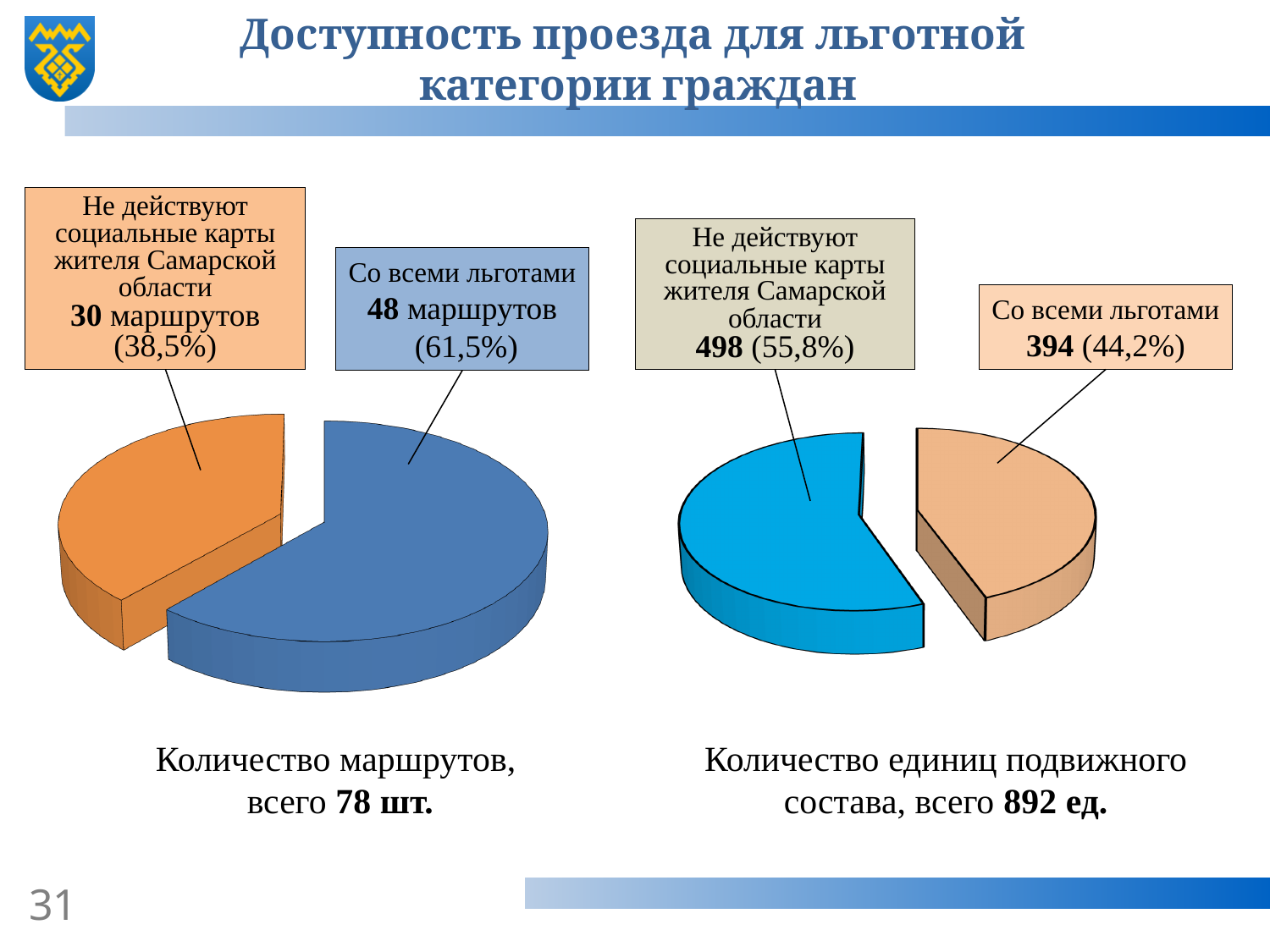
In the right pie chart (Количество единиц подвижного состава), what share of the pie is the 'Со всеми льготами' slice? 44,2% In the left pie chart (Количество маршрутов), what is the difference in routes between the 'Со всеми льготами' slice and the 'Не действуют социальные карты' slice? 18 What type of chart is used on the left of the slide (Количество маршрутов)? pie chart In the left pie chart (Количество маршрутов), which slice is larger: 'Со всеми льготами' or 'Не действуют социальные карты жителя Самарской области'? Со всеми льготами In the left pie chart (Количество маршрутов), how many routes are in the 'Со всеми льготами' slice? 48 In the left pie chart (Количество маршрутов), what share of the pie is the 'Не действуют социальные карты жителя Самарской области' slice? 38,5% In the right pie chart (Количество единиц подвижного состава), which slice is the largest? Не действуют социальные карты жителя Самарской области In the right pie chart (Количество единиц подвижного состава), how many units are in the 'Не действуют социальные карты жителя Самарской области' slice? 498 In the left pie chart (Количество маршрутов), what is the total number of routes? 78 шт. In the right pie chart (Количество единиц подвижного состава), what is the difference between the 'Не действуют социальные карты' slice and the 'Со всеми льготами' slice? 104 How many slices does the right pie chart (Количество единиц подвижного состава) have? 2 In the right pie chart (Количество единиц подвижного состава), what is the total number of units? 892 ед.